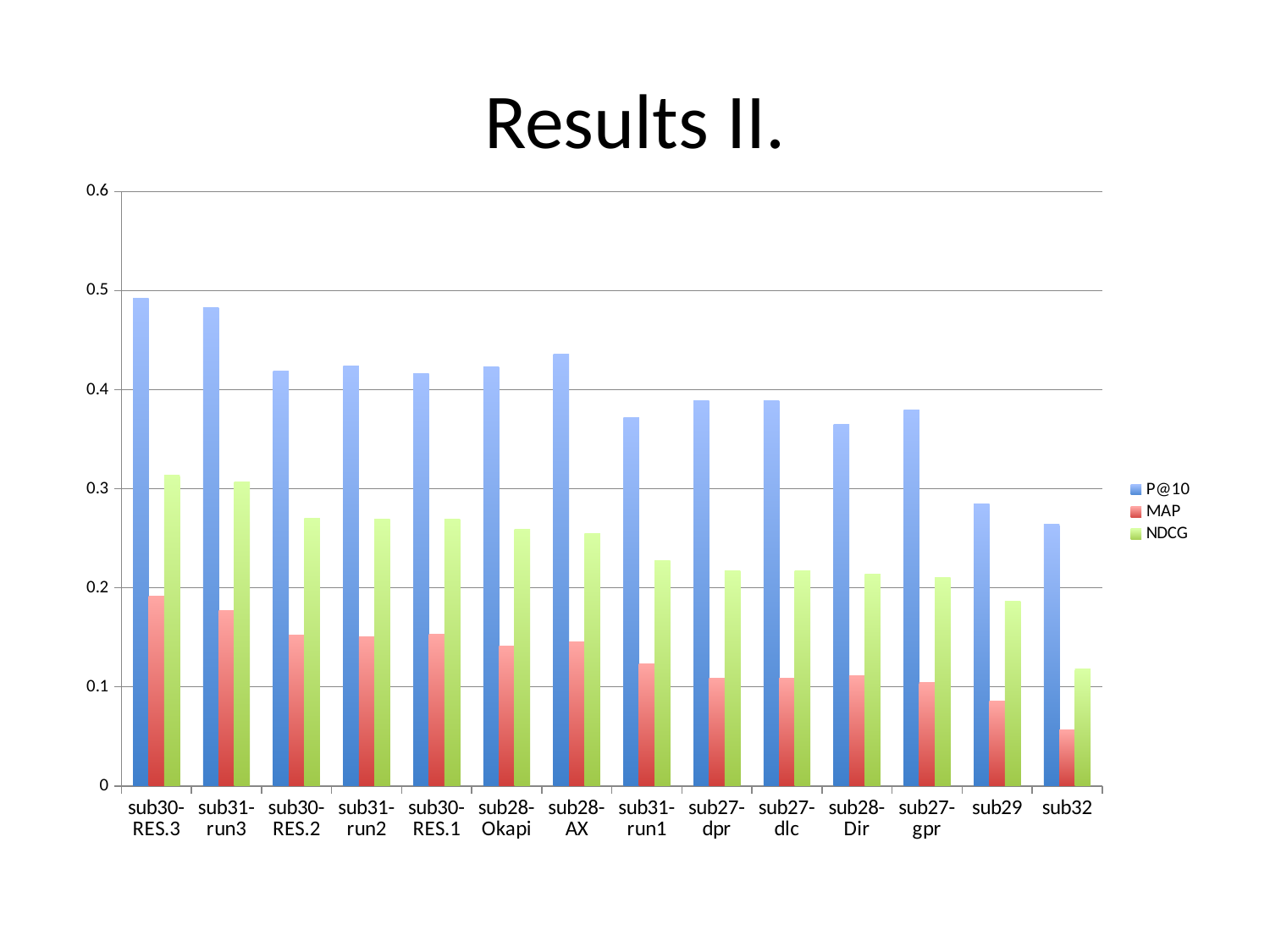
Which category has the lowest P@10 value? sub32 Do the P@10 values generally rise or fall from left to right along the x axis? fall Is the MAP value for sub32 greater or less than 0.1? less Which is larger, the NDCG value for sub28-Okapi or for sub32? sub28-Okapi How many series does the legend list? 3 Is the P@10 value for sub30-RES.3 greater or less than 0.4? greater Is the NDCG value for sub29 greater or less than 0.2? less Which category has the highest MAP value? sub30-RES.3 What kind of chart is shown on the slide? bar chart Which is larger, the P@10 value for sub28-AX or for sub31-run1? sub28-AX Which category has the lowest NDCG value? sub32 How many categories are shown on the x axis? 14